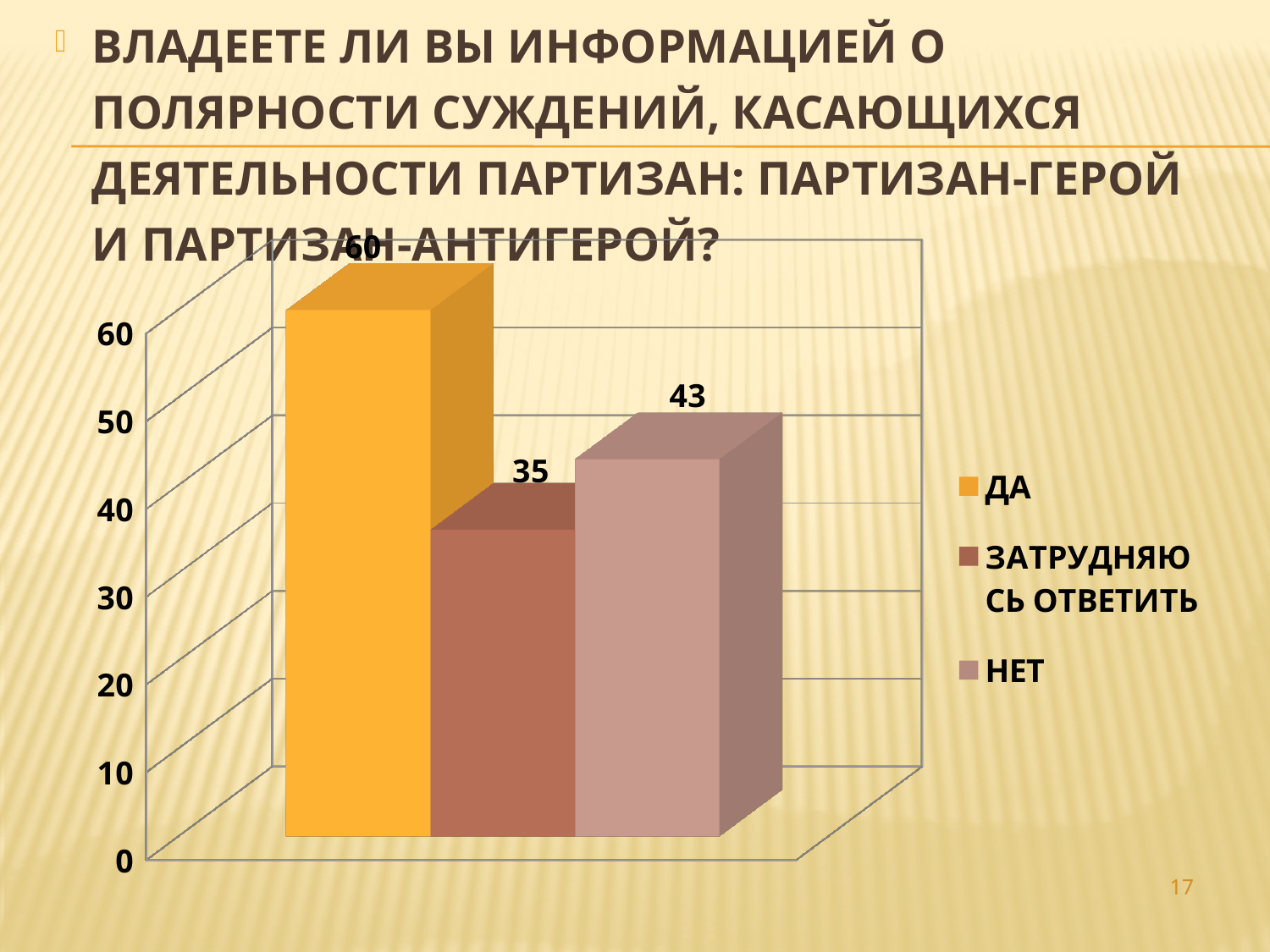
Is the value for ДА greater or less than 50? greater What is the value for ЗАТРУДНЯЮСЬ ОТВЕТИТЬ? 35 What is the value for ДА? 60 Which answer option has the lowest value? ЗАТРУДНЯЮСЬ ОТВЕТИТЬ Which answer option has the highest value? ДА Which is larger, the value for НЕТ or the value for ЗАТРУДНЯЮСЬ ОТВЕТИТЬ? НЕТ What colour is the bar for ДА? orange What is the value for НЕТ? 43 What is the difference between the values for ДА and НЕТ? 17 How many series does the legend list? 3 What kind of chart is shown on the slide? bar chart What is the difference between the values for НЕТ and ЗАТРУДНЯЮСЬ ОТВЕТИТЬ? 8